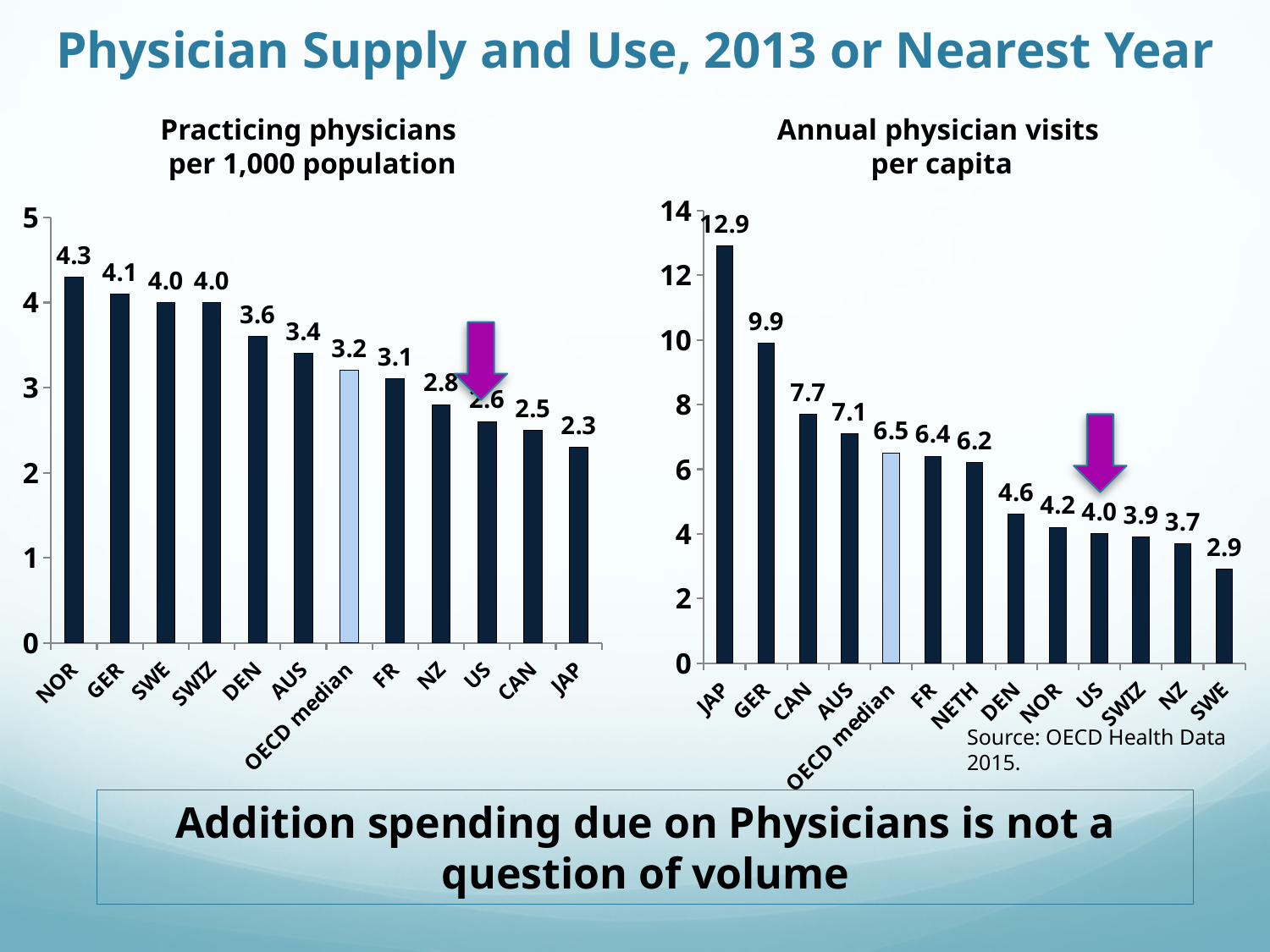
In the 'Annual physician visits per capita' chart, do the values rise or fall from left to right? fall What kind of chart is the 'Annual physician visits per capita' chart? bar chart In the 'Practicing physicians per 1,000 population' chart, which country has the lowest value? JAP In the 'Annual physician visits per capita' chart, which is larger, GER or CAN? GER In the 'Annual physician visits per capita' chart, which country has the highest value? JAP In the 'Annual physician visits per capita' chart, what is the value for JAP? 12.9 In the 'Practicing physicians per 1,000 population' chart, what is the value for NOR? 4.3 In the 'Annual physician visits per capita' chart, what is the difference between the OECD median and SWE? 3.6 In the 'Practicing physicians per 1,000 population' chart, what is the value for the OECD median? 3.2 In the 'Annual physician visits per capita' chart, what is the value for US? 4.0 In the 'Practicing physicians per 1,000 population' chart, how many bars are shown? 12 In the 'Practicing physicians per 1,000 population' chart, what is the difference between NOR and US? 1.7